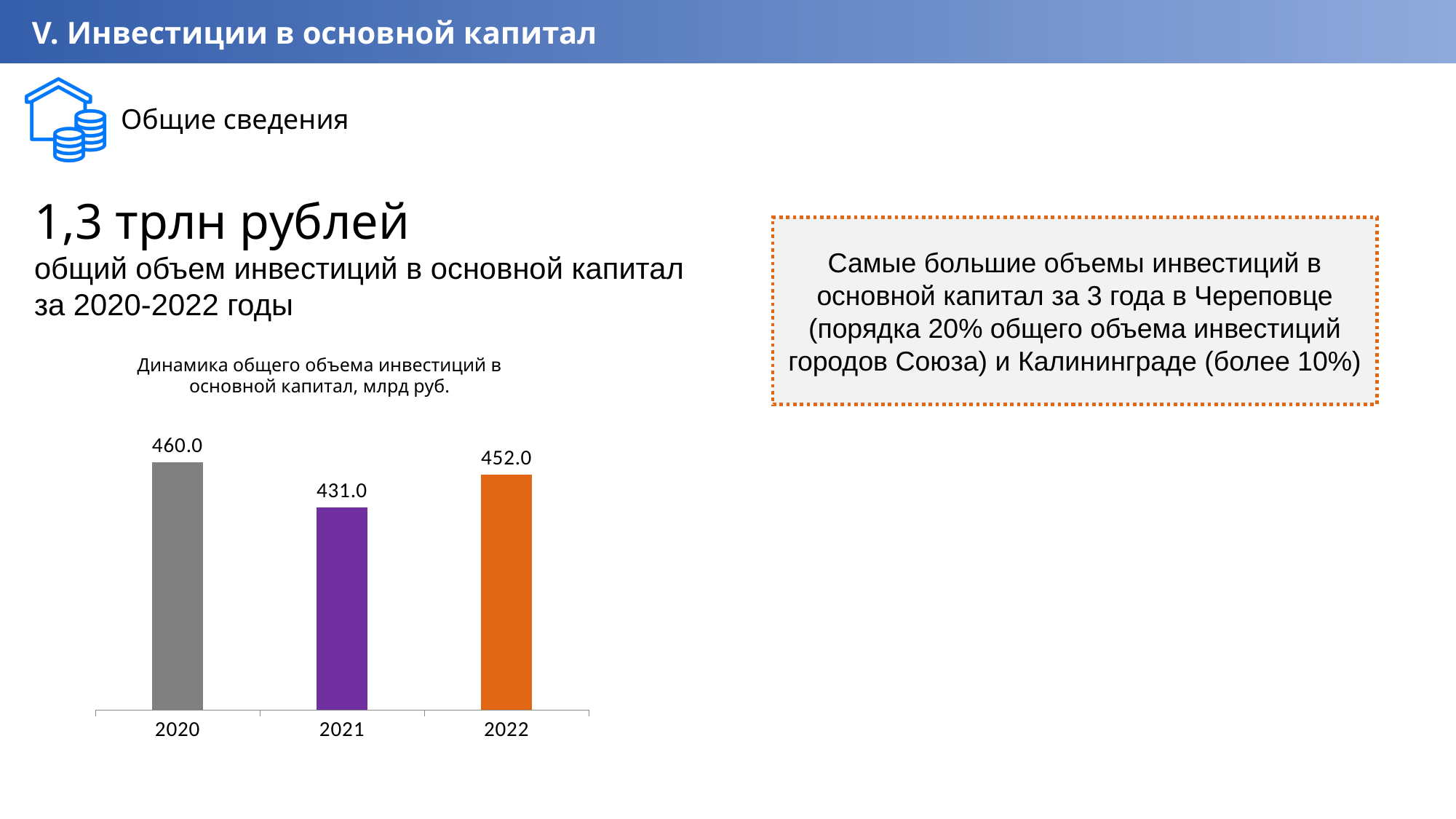
What is the title of the chart? Динамика общего объема инвестиций в основной капитал, млрд руб. What is the value for 2021? 431.0 What is the difference between the values for 2022 and 2021? 21.0 Which year has the lowest value? 2021 What kind of chart is shown? bar chart What colour is the bar for 2022? orange Which year has the highest value? 2020 How many years are shown on the chart? 3 Which is larger, the value for 2020 or the value for 2022? 2020 What is the difference between the values for 2020 and 2021? 29.0 What is the value for 2020? 460.0 What is the value for 2022? 452.0